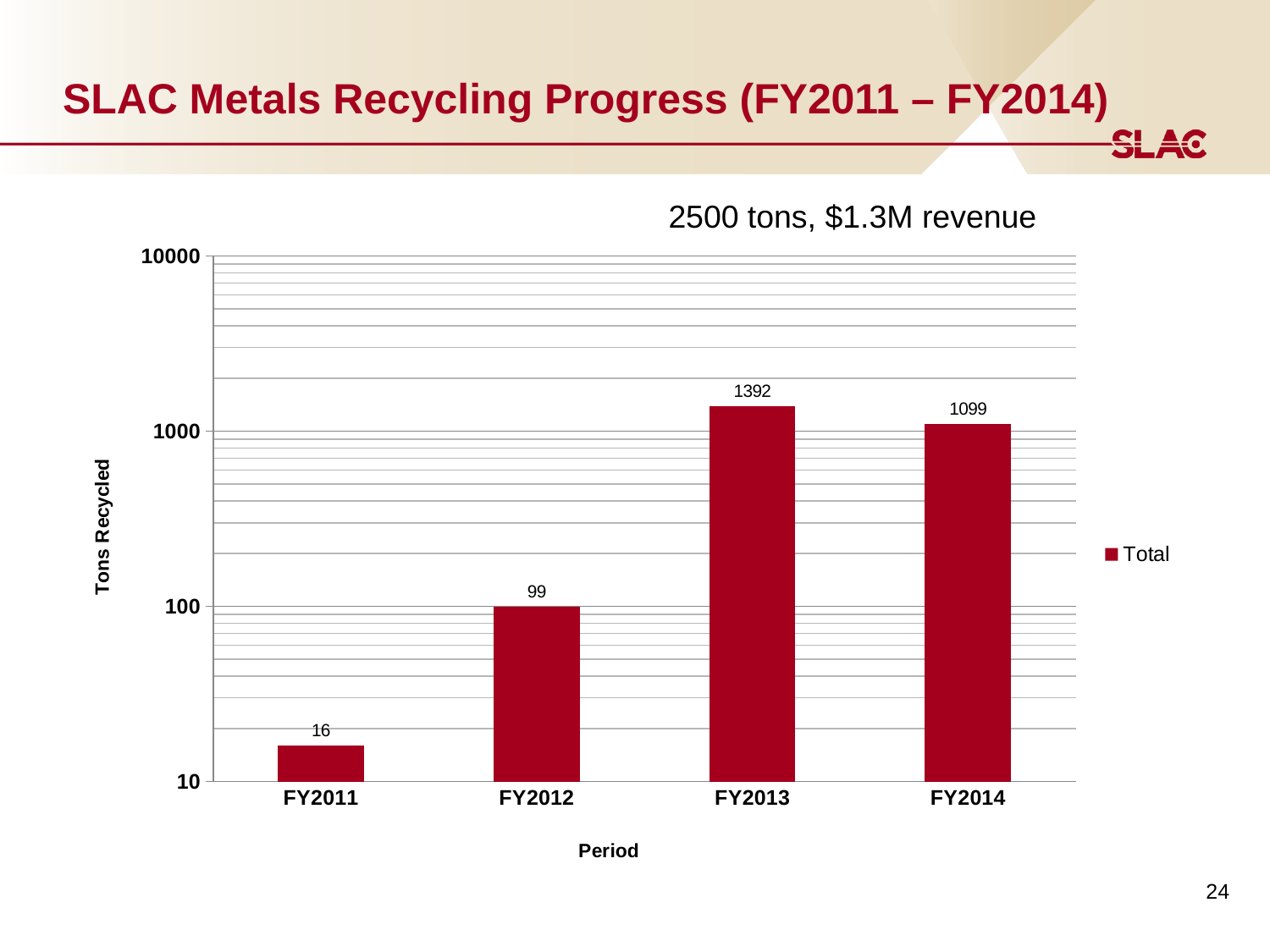
What is the label of the y axis? Tons Recycled What is the value for FY2011? 16 Is the value for FY2012 greater or less than 1000? less What is the difference between the FY2013 and FY2014 values? 293 Which period has the lowest tons recycled? FY2011 Which period has the highest tons recycled? FY2013 What kind of chart is shown on the slide? bar chart How many periods are shown on the x axis? 4 Which is larger, the value for FY2012 or the value for FY2014? FY2014 What is the difference between the FY2012 and FY2011 values? 83 What is the value for FY2014? 1099 How many tons were recycled in FY2013? 1392